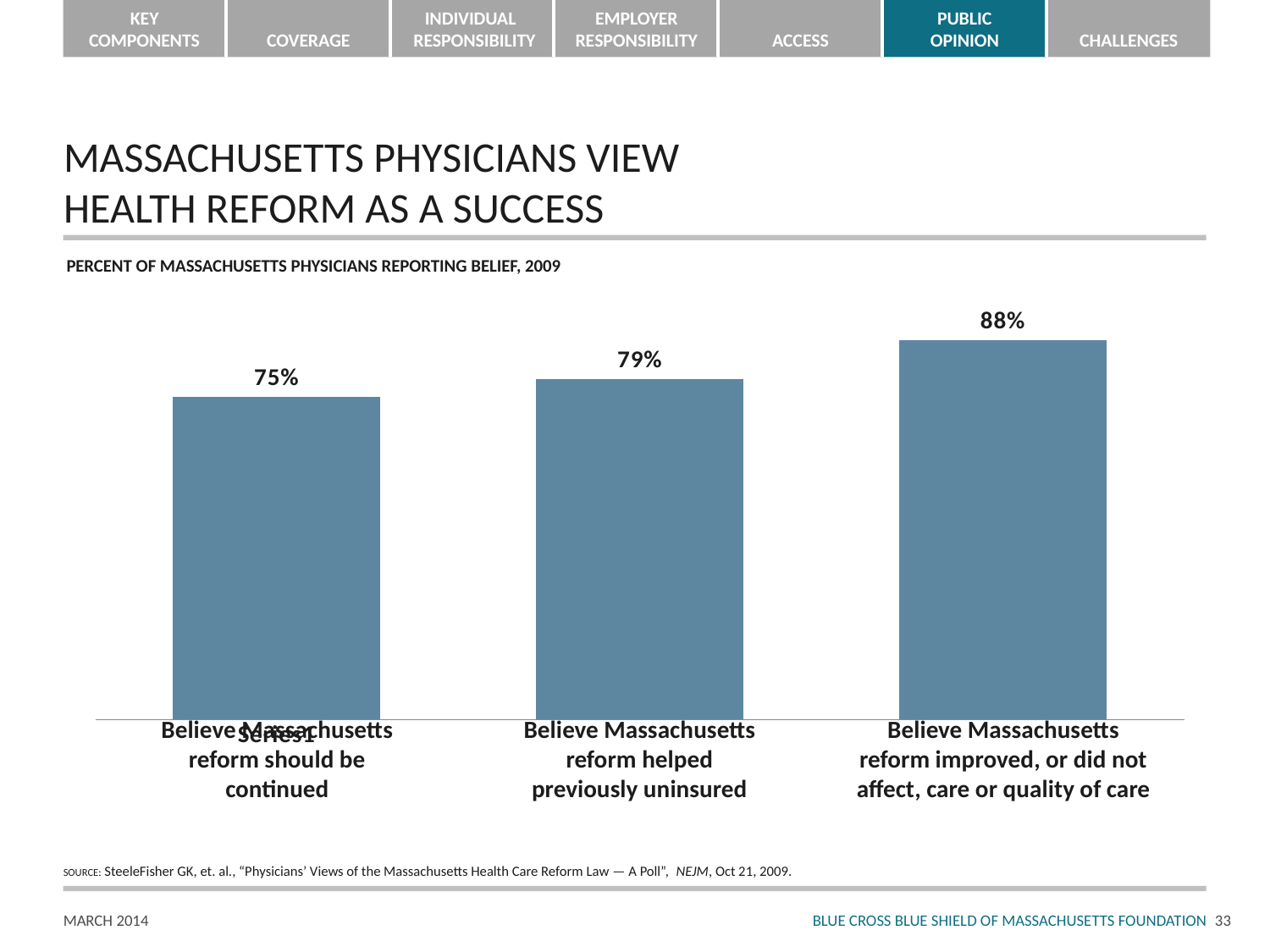
How many categories are shown in the chart? 3 What kind of chart is shown on the slide? Bar chart Which belief has the lowest percentage of physicians reporting it? Believe Massachusetts reform should be continued What percent of Massachusetts physicians believe Massachusetts reform improved, or did not affect, care or quality of care? 88% What year does the chart subtitle say the physician beliefs were reported? 2009 What percent of Massachusetts physicians believe Massachusetts reform helped previously uninsured? 79% Do the values rise or fall from left to right across the chart? Rise Which belief has the highest percentage of physicians reporting it? Believe Massachusetts reform improved, or did not affect, care or quality of care What percent of Massachusetts physicians believe Massachusetts reform should be continued? 75% Which is larger: the percent who believe reform helped previously uninsured or the percent who believe reform should be continued? Believe Massachusetts reform helped previously uninsured What is the difference in percentage points between physicians who believe reform helped previously uninsured and those who believe reform should be continued? 4 What is the difference in percentage points between physicians who believe reform improved or did not affect care and those who believe reform should be continued? 13